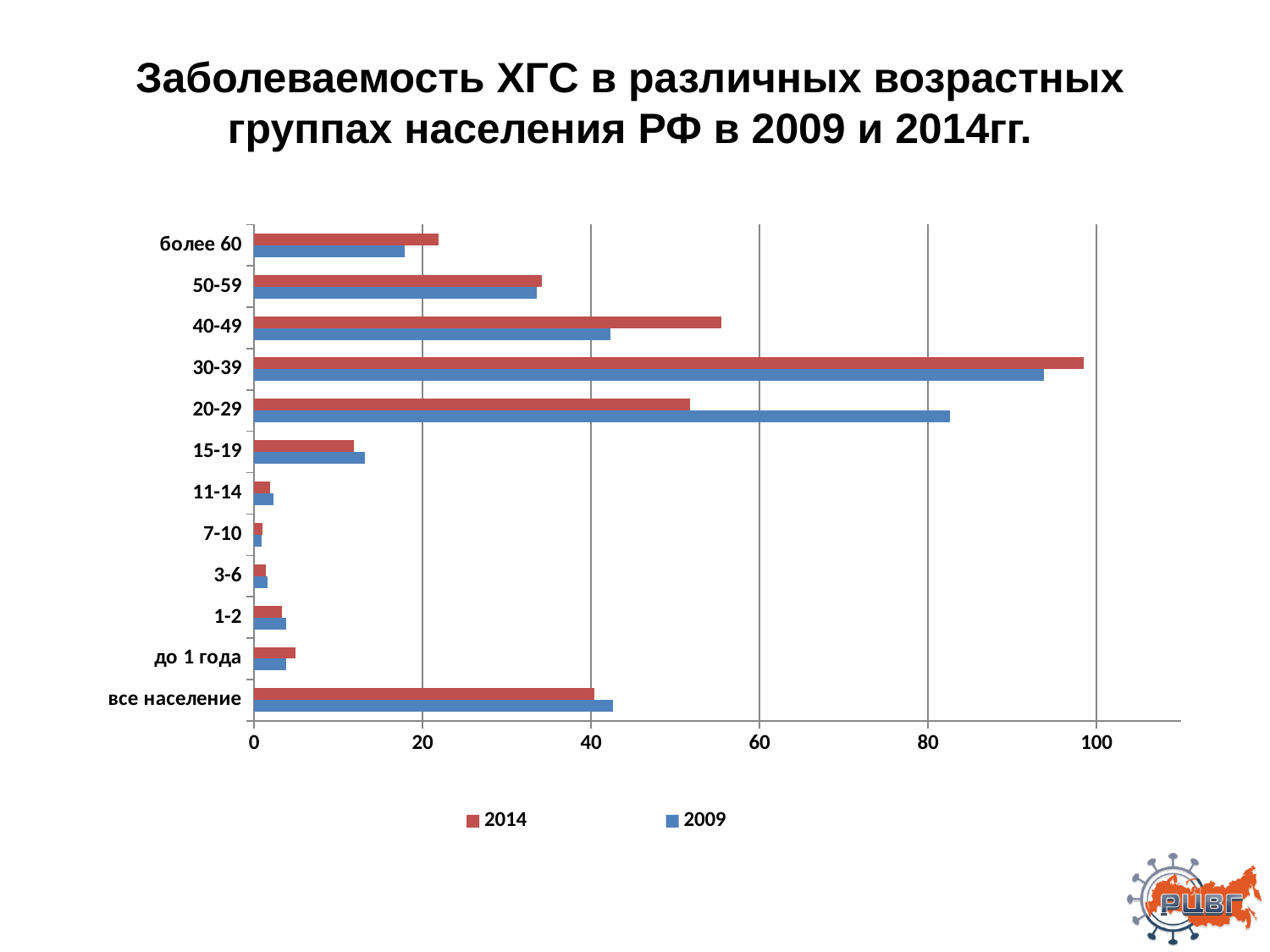
Is the 2014 value for 30-39 greater or less than 80? greater Is the 2009 value for более 60 greater or less than 20? less Is the 2009 value for 20-29 greater or less than 60? greater Which category has the highest value for 2014? 30-39 How many age-group categories are plotted on the chart? 12 Which category has the highest value for 2009? 30-39 How many series does the legend list? 2 Which colour represents the 2014 series in the legend? red Which category has the lowest value for 2014? 7-10 For the 20-29 group, which year has the larger value, 2014 or 2009? 2009 What kind of chart is shown on the slide? bar chart